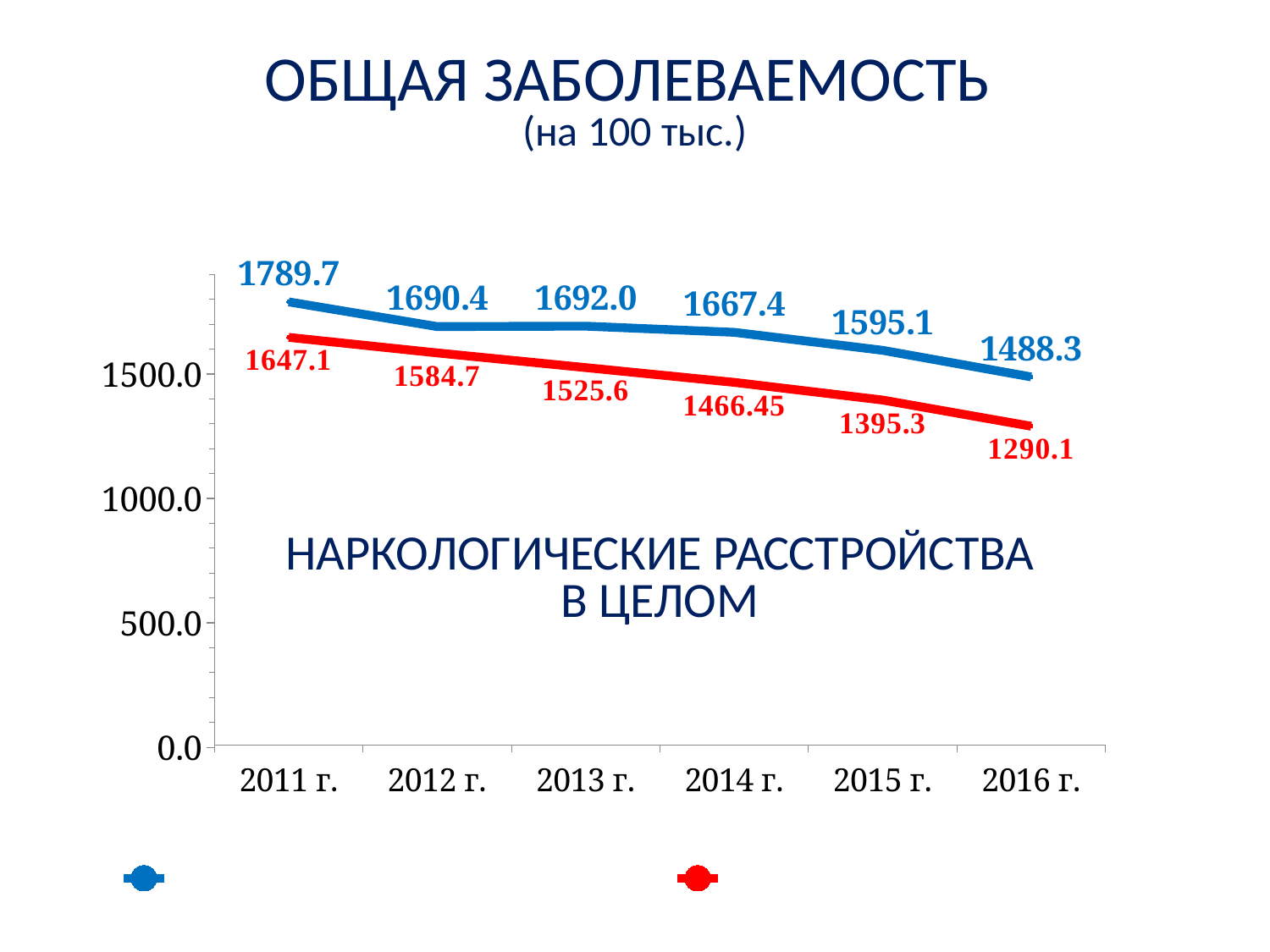
Is the value of the red line in 2015 г. greater or less than 1500.0? less What is the value of the red line for 2012 г.? 1584.7 What is the value of the red line for 2014 г.? 1466.45 What kind of chart is shown on the slide? line chart How many series does the legend list? 2 How many years are shown on the x axis? 6 What is the difference between the blue line and the red line in 2016 г.? 198.2 Which is larger: the blue line's value in 2013 г. or its value in 2015 г.? 2013 г. In which year does the red line reach its lowest value? 2016 г. What is the value of the blue line for 2011 г.? 1789.7 What is the value of the blue line for 2016 г.? 1488.3 In which year does the blue line reach its highest value? 2011 г.